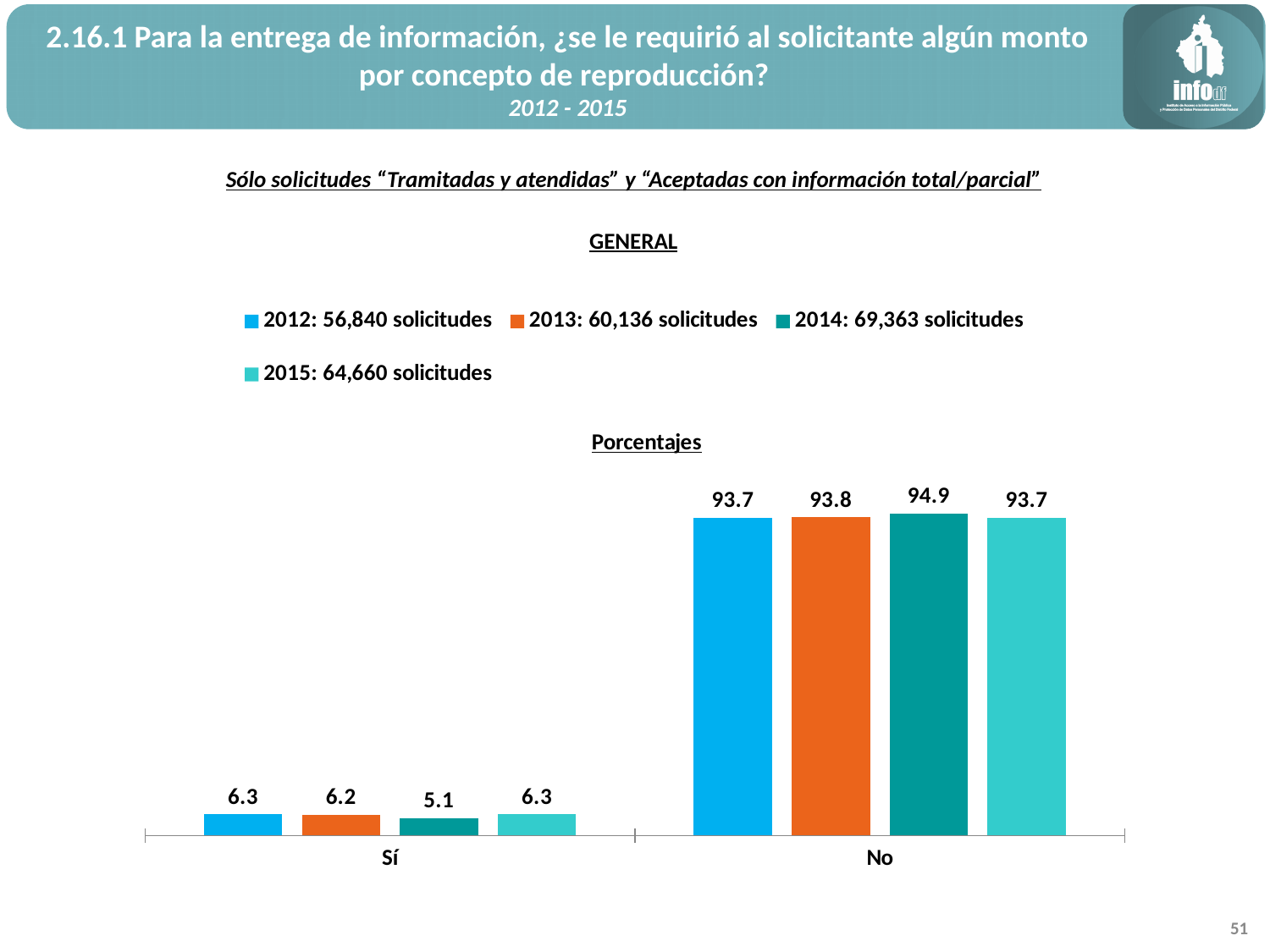
What is the value for 2014 in the "No" category? 94.9 Which is larger: the 2013 value for "Sí" or the 2014 value for "Sí"? 2013 How many series does the legend list? 4 What kind of chart is shown on the slide? Bar chart What is the value for 2015 in the "No" category? 93.7 What is the value for 2013 in the "Sí" category? 6.2 According to the legend, how many solicitudes were there in 2014? 69,363 solicitudes What is the difference between the 2014 and 2012 values in the "No" category? 1.2 What is the value for 2012 in the "Sí" category? 6.3 Which year has the highest value in the "No" category? 2014 Which year has the lowest value in the "Sí" category? 2014 How many categories are shown on the x axis? 2